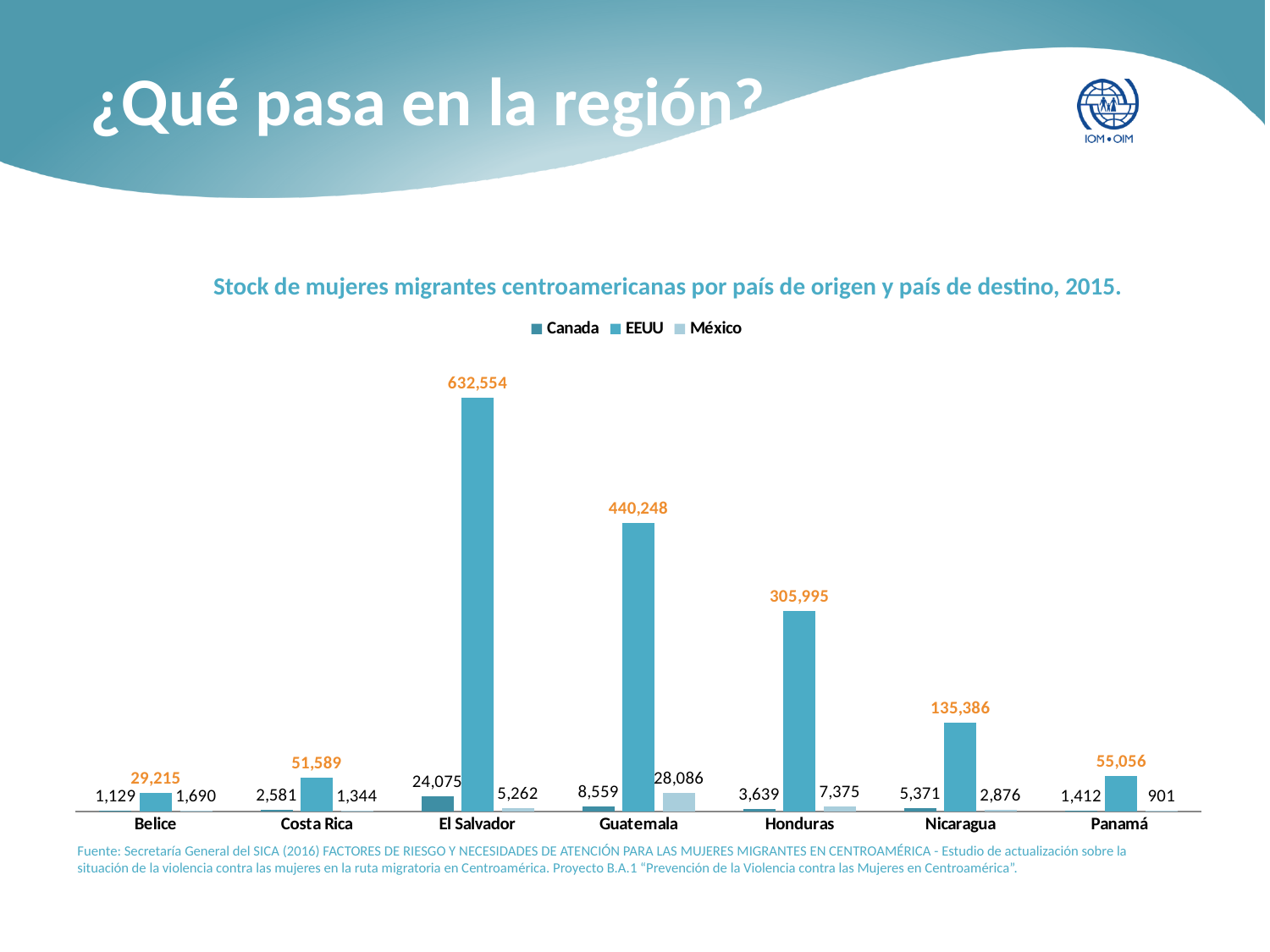
What kind of chart is shown on the slide? Bar chart What is the value for Canada for Guatemala? 8,559 How many countries are shown on the x axis? 7 Which country has the highest EEUU value? El Salvador What is the value for México for Honduras? 7,375 How many series does the legend list? 3 What is the value for EEUU for El Salvador? 632,554 Which is larger for Nicaragua: the Canada value or the México value? Canada What is the title of the chart? Stock de mujeres migrantes centroamericanas por país de origen y país de destino, 2015. What is the difference between the EEUU values for El Salvador and Guatemala? 192,306 Which country has the lowest México value? Panamá What is the total of the three values for Panamá? 57,369